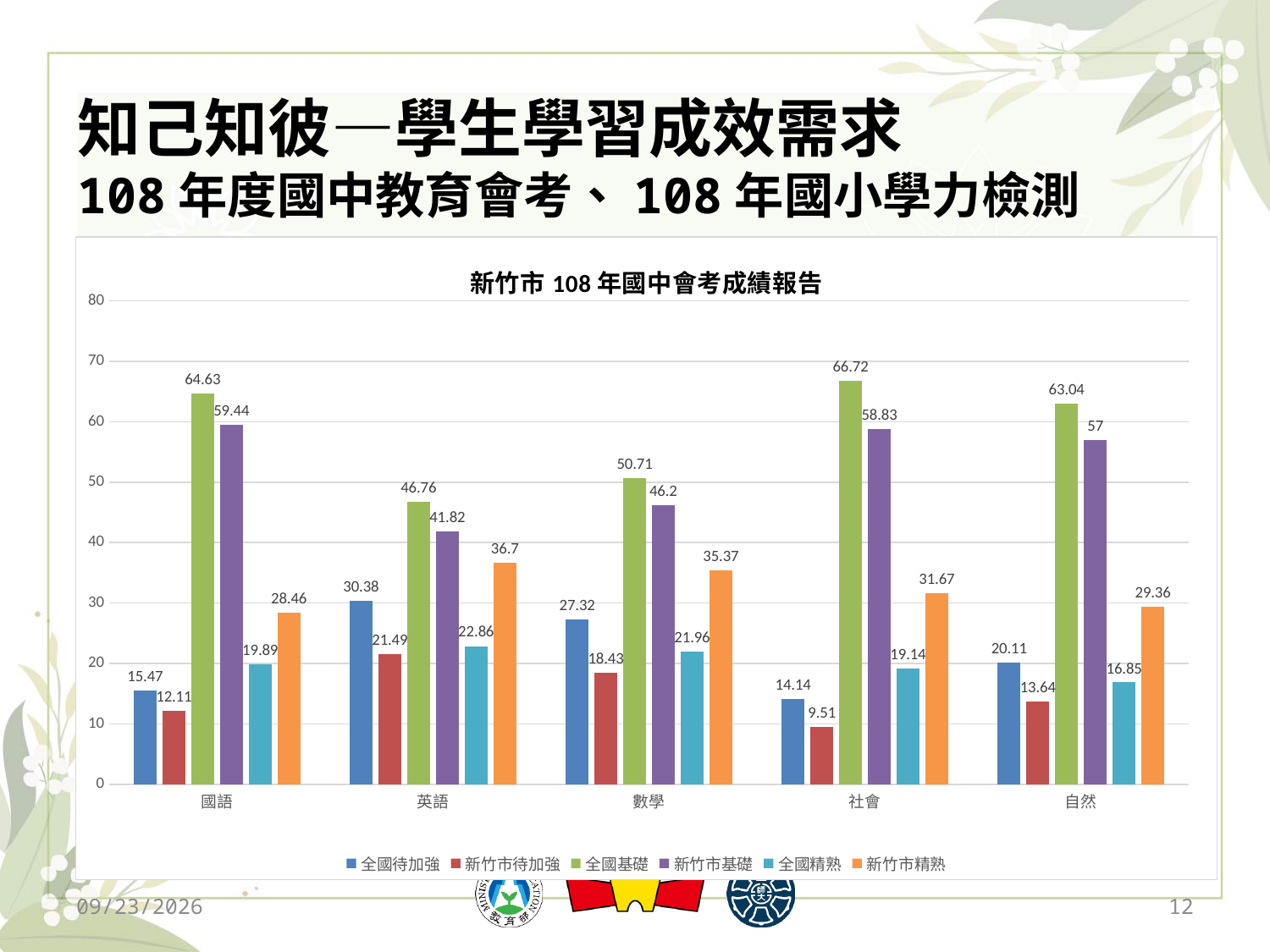
Which subject has the lowest value for 新竹市待加強? 社會 What is the difference between 全國基礎 and 新竹市基礎 for 國語? 5.19 Which is larger for 數學: 全國精熟 or 新竹市精熟? 新竹市精熟 What is the title of the chart? 新竹市 108 年國中會考成績報告 How many subjects are shown on the x axis? 5 Is the value of 新竹市基礎 for 自然 greater or less than 50? greater What kind of chart is shown? bar chart What is the value of 新竹市精熟 for 英語? 36.7 What is the value of 新竹市待加強 for 社會? 9.51 How many series does the legend list? 6 Which subject has the highest value for 全國基礎? 社會 What is the value of 全國基礎 for 社會? 66.72